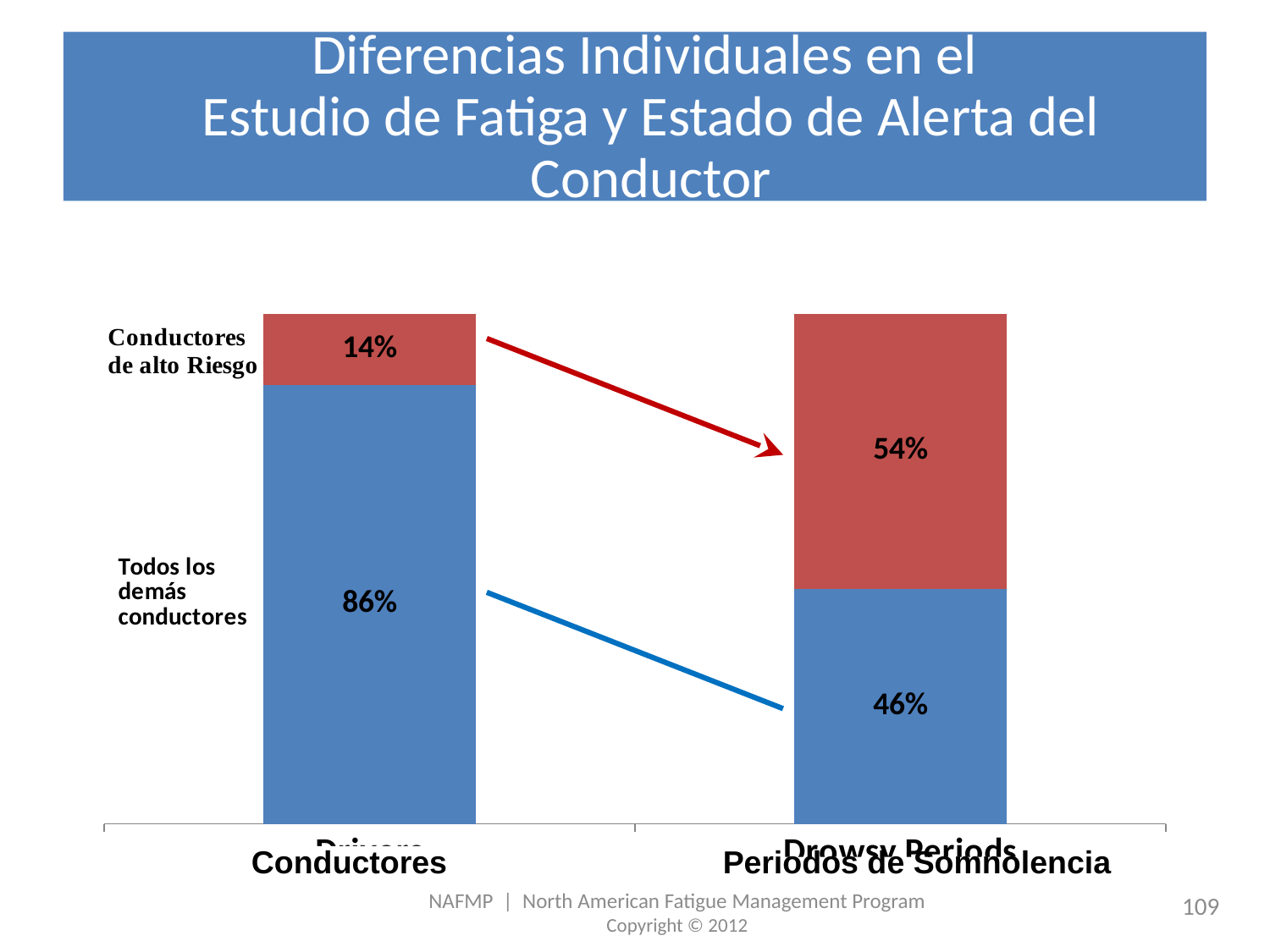
In the Conductores bar, which group has the larger share: Conductores de alto Riesgo or Todos los demás conductores? Todos los demás conductores What is the difference between the two segments in the Conductores bar? 72% What is the difference between the Conductores de alto Riesgo share in Periodos de Somnolencia and in Conductores? 40% What percentage of Conductores are Todos los demás conductores? 86% What share of Periodos de Somnolencia is attributed to Conductores de alto Riesgo? 54% What is the total of the stacked bar for Conductores? 100% How many categories are shown on the x axis of the chart? 2 What type of chart is shown on the slide? Stacked bar chart Which colour represents Conductores de alto Riesgo in the chart? Red What percentage of Conductores are Conductores de alto Riesgo? 14% In the Periodos de Somnolencia bar, which group has the larger share: Conductores de alto Riesgo or Todos los demás conductores? Conductores de alto Riesgo What share of Periodos de Somnolencia is attributed to Todos los demás conductores? 46%